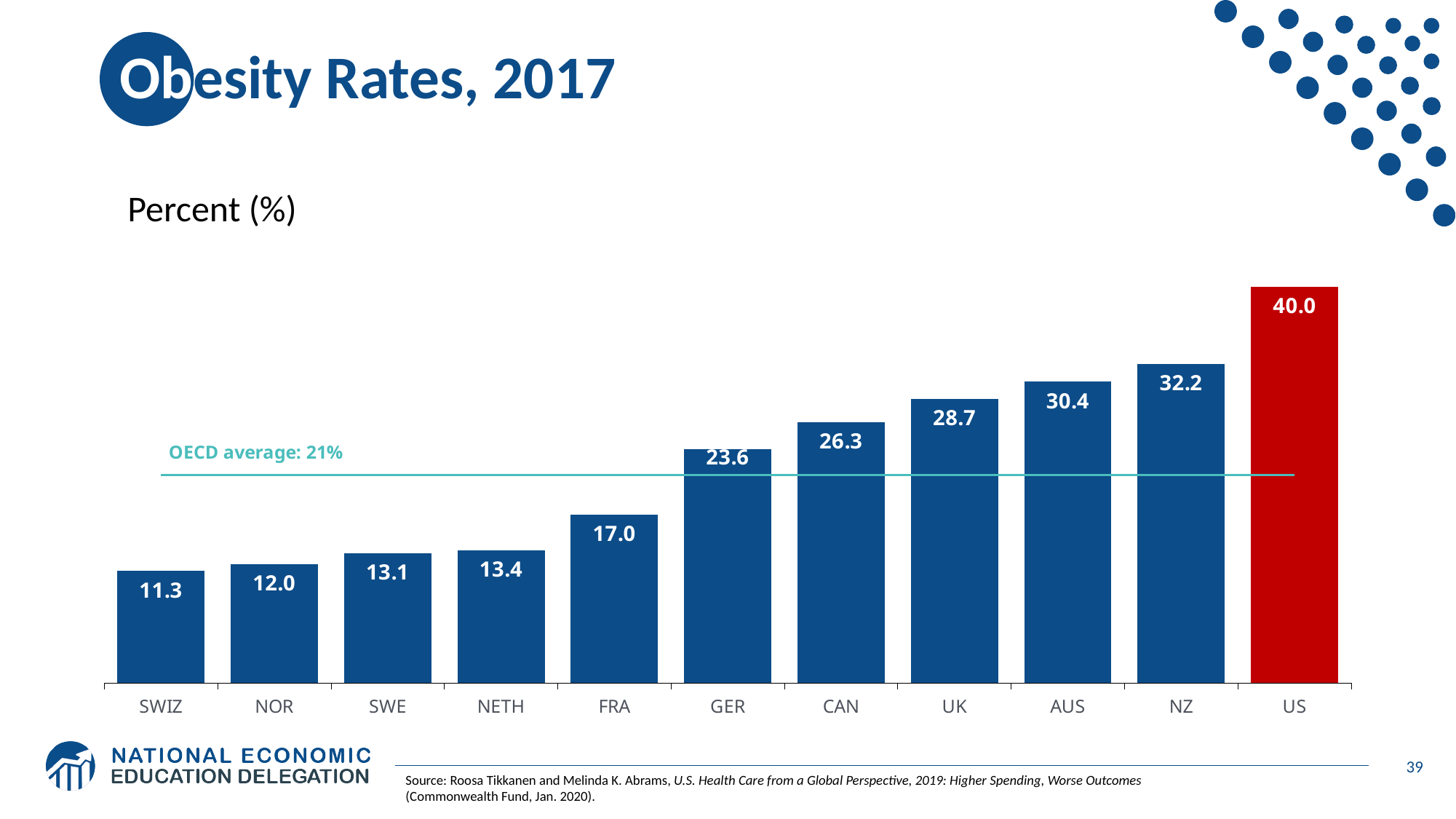
Which country's bar is coloured red rather than blue? US Do the obesity rates rise or fall moving from left to right across the chart? Rise What is the obesity rate shown for Germany (GER)? 23.6 What OECD average value is marked by the horizontal line on the chart? 21% What is the obesity rate shown for the US? 40.0 Which country has the highest obesity rate on the chart? US What is the obesity rate shown for Switzerland (SWIZ)? 11.3 Which has a higher obesity rate, CAN or UK? UK How many countries are shown on the chart? 11 What kind of chart is shown on the slide? Bar chart What is the difference between the obesity rates of the US and NZ? 7.8 Which country has the lowest obesity rate on the chart? SWIZ